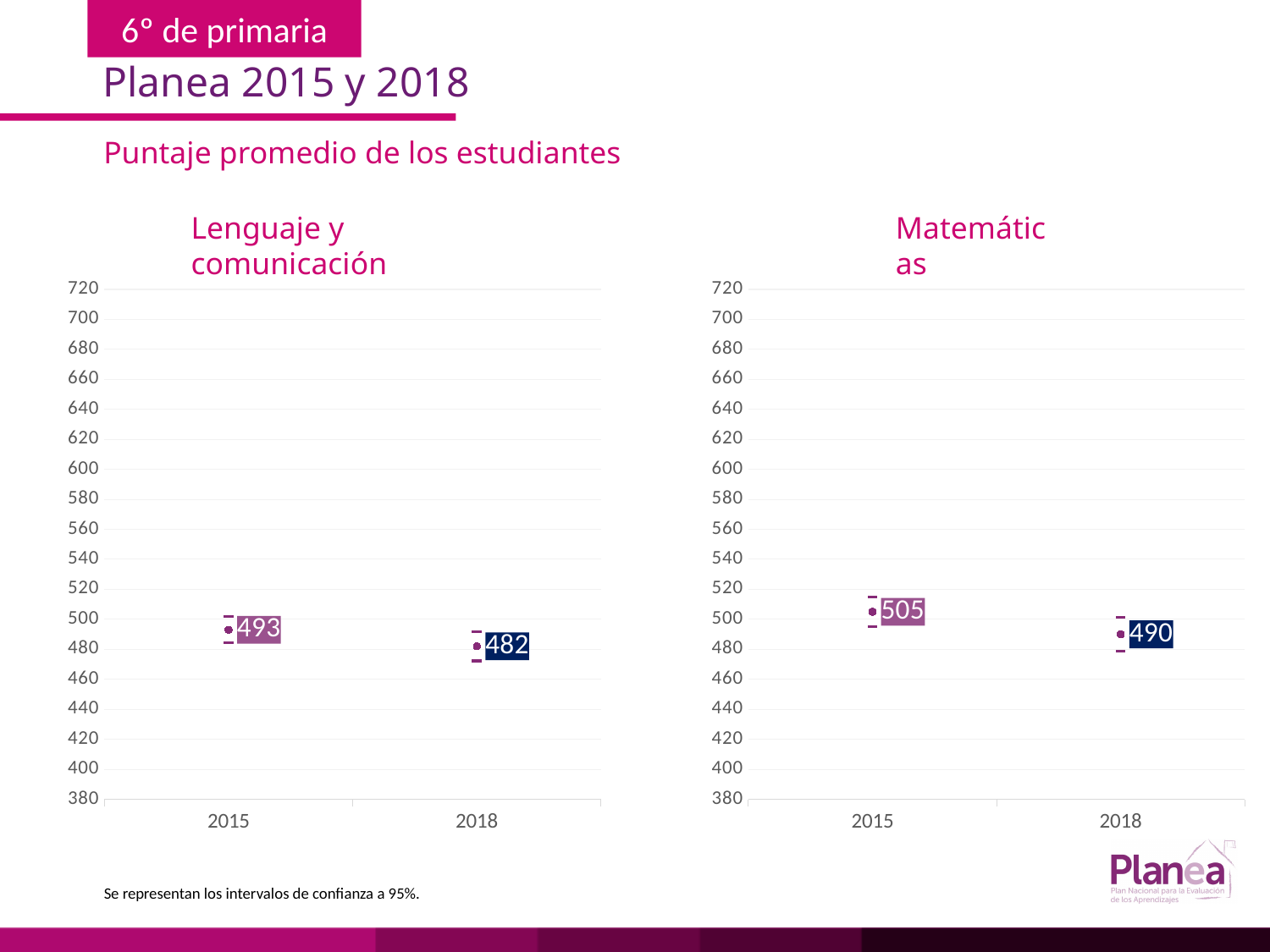
What is the title of the chart on the left side of the slide? Lenguaje y comunicación In the 'Matemáticas' chart, which year has the higher value? 2015 In the 'Lenguaje y comunicación' chart, which year has the lower value? 2018 In the 'Lenguaje y comunicación' chart, what is the value for 2018? 482 In the 'Lenguaje y comunicación' chart, what is the difference between the 2015 and 2018 values? 11 In the 'Lenguaje y comunicación' chart, do the values rise or fall from 2015 to 2018? fall In the 'Matemáticas' chart, is the value for 2015 greater or less than 500? greater How many years are plotted on the x axis of the 'Matemáticas' chart? 2 In the 'Matemáticas' chart, what is the value for 2018? 490 In the 'Lenguaje y comunicación' chart, what is the value for 2015? 493 In the 'Matemáticas' chart, what is the difference between the 2015 and 2018 values? 15 In the 'Matemáticas' chart, what is the value for 2015? 505